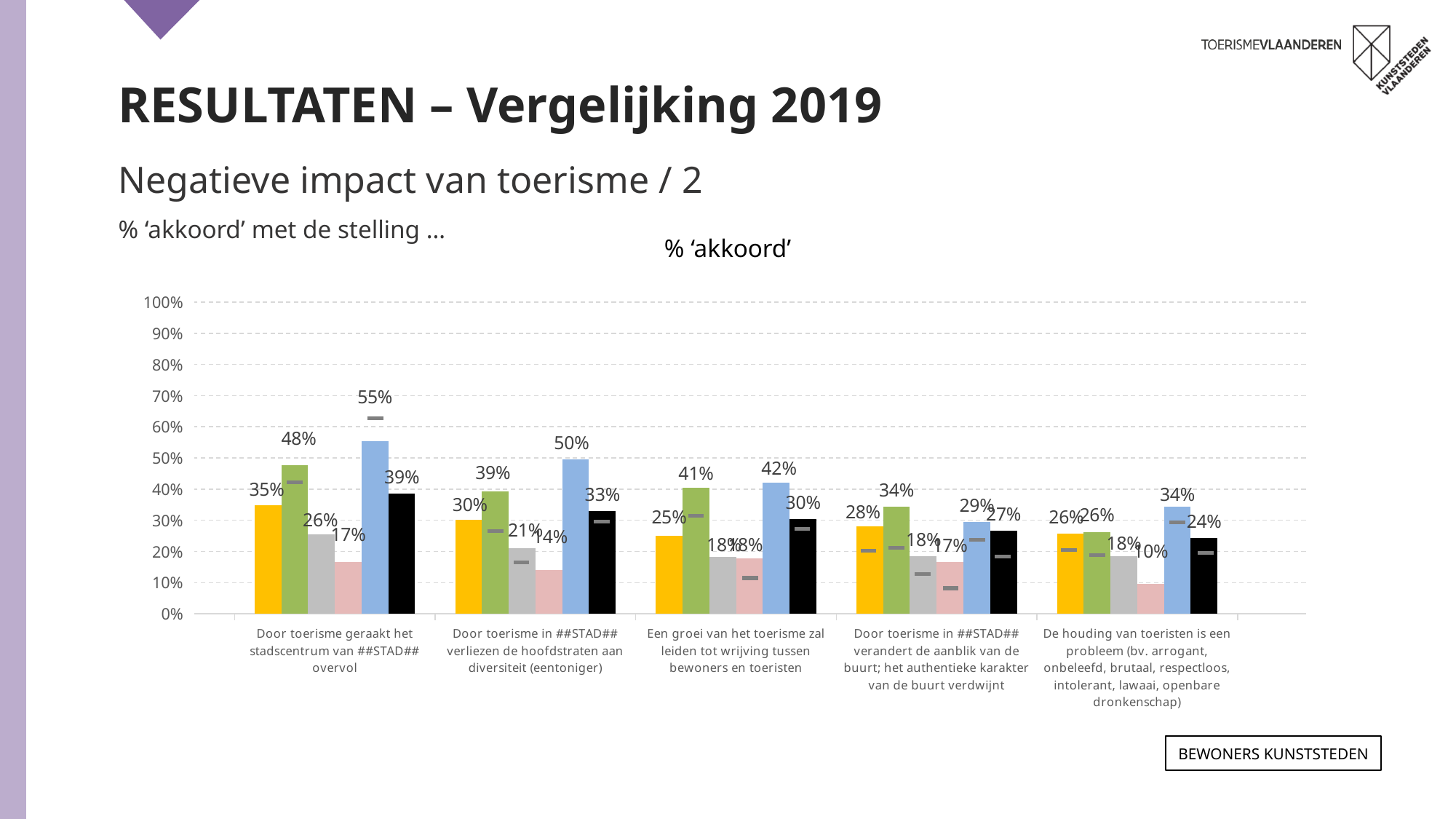
What is the value of the pink bar for the statement 'De houding van toeristen is een probleem'? 10% What is the value of the blue bar for the statement 'Door toerisme geraakt het stadscentrum van ##STAD## overvol'? 55% For the statement 'Door toerisme in ##STAD## verandert de aanblik van de buurt', which is larger: the green bar or the blue bar? the green bar What is the value of the yellow bar for the statement 'Een groei van het toerisme zal leiden tot wrijving tussen bewoners en toeristen'? 25% Is the value of the black bar for the statement 'Door toerisme geraakt het stadscentrum van ##STAD## overvol' greater or less than 30%? greater Which statement has the highest blue bar? Door toerisme geraakt het stadscentrum van ##STAD## overvol What is the title of the chart? % ‘akkoord’ What is the value of the green bar for the statement 'Een groei van het toerisme zal leiden tot wrijving tussen bewoners en toeristen'? 41% How many statement categories are shown along the x axis of the chart? 5 What kind of chart is shown on the slide? bar chart What is the difference between the blue bar (50%) and the yellow bar (30%) for the statement 'Door toerisme in ##STAD## verliezen de hoofdstraten aan diversiteit'? 20% Which statement has the lowest pink bar? De houding van toeristen is een probleem